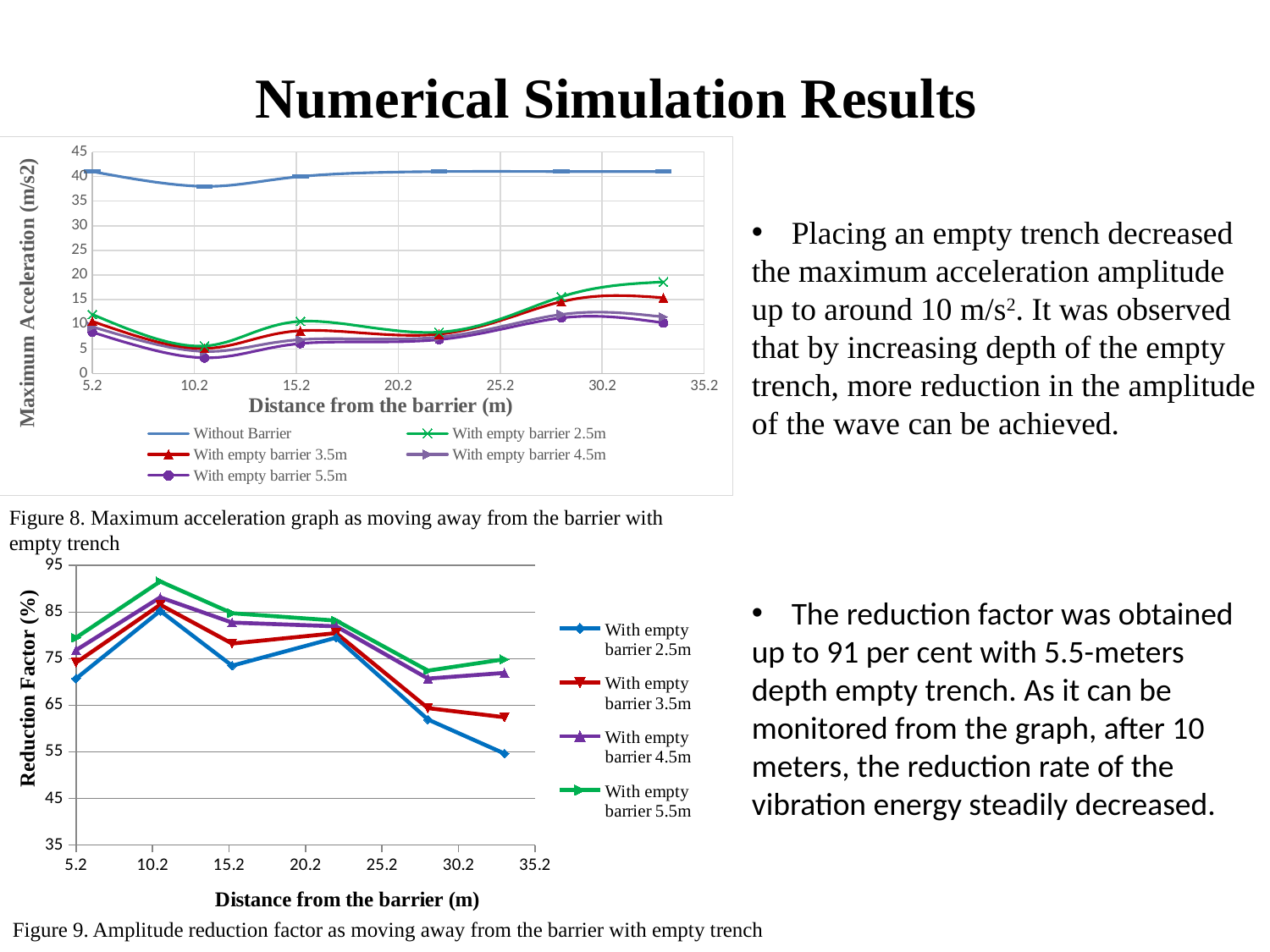
In the top chart (Maximum Acceleration), is the value for With empty barrier 5.5m at its lowest point (near 10.2 m) greater or less than 5? less What is the x-axis title of the top chart (Maximum Acceleration)? Distance from the barrier (m) In the bottom chart (Reduction Factor), which series has the highest reduction factor at 10.2 m? With empty barrier 5.5m In the top chart (Maximum Acceleration), is the value for With empty barrier 2.5m at the rightmost point greater or less than 15? greater In the bottom chart (Reduction Factor), do the values for With empty barrier 2.5m rise or fall from 10.2 m to 35.2 m? fall In the top chart (Maximum Acceleration), is the value for Without Barrier at 10.2 m greater or less than 35? greater How many series does the legend of the bottom chart (Reduction Factor) list? 4 In the top chart (Maximum Acceleration), which series has the highest values across the whole distance range? Without Barrier What kind of chart is the top chart (Figure 8, Maximum Acceleration)? line chart In the bottom chart (Reduction Factor), at the rightmost point, which is larger: With empty barrier 5.5m or With empty barrier 2.5m? With empty barrier 5.5m How many series does the legend of the top chart (Maximum Acceleration) list? 5